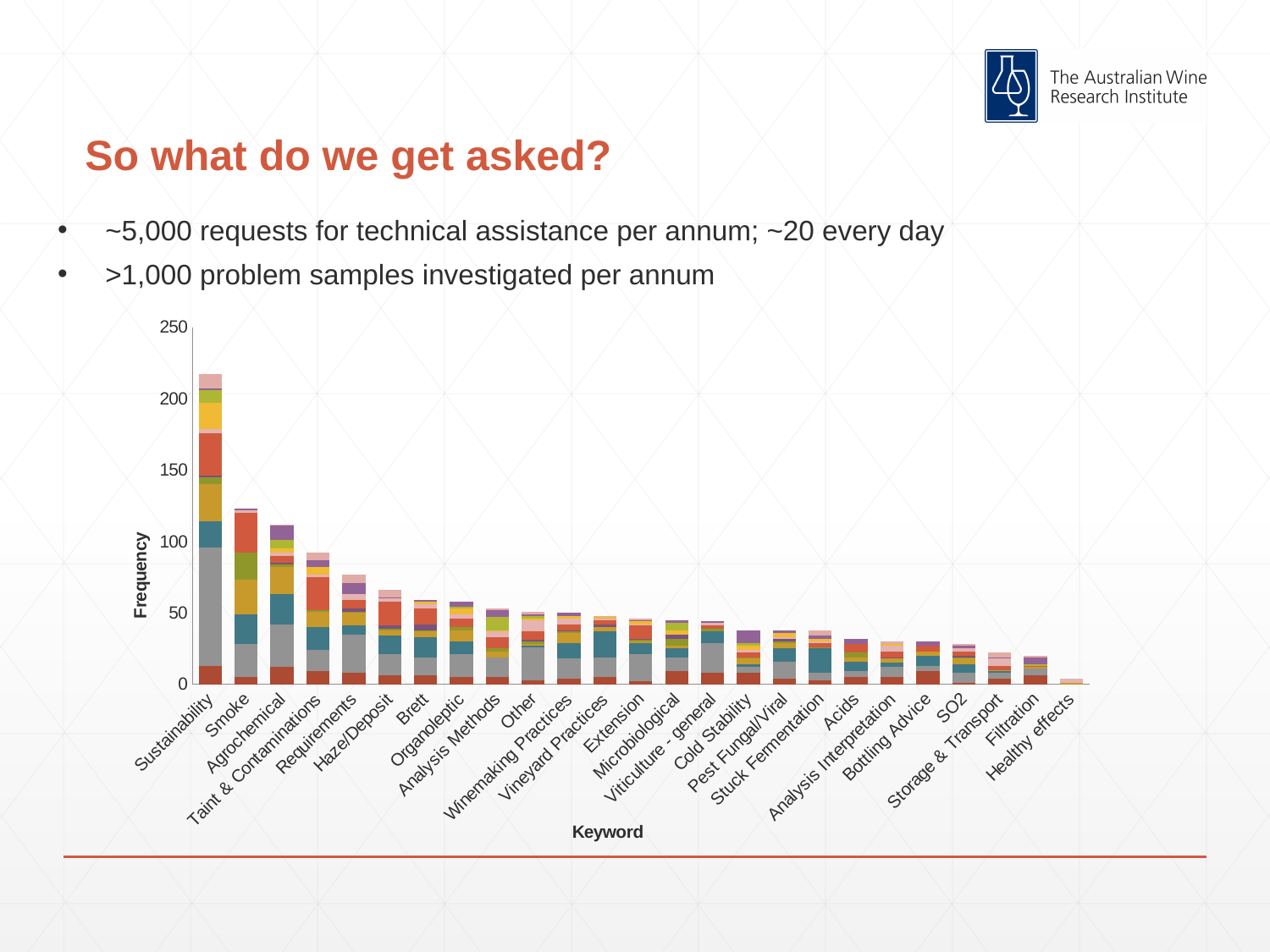
Which has a higher total frequency, Taint & Contaminations or Requirements? Taint & Contaminations Is the total frequency for Taint & Contaminations greater or less than 100? less Do the total frequencies rise or fall moving from left to right along the x axis? fall How many keyword categories are plotted along the x axis of the chart? 25 Is the total frequency for Smoke greater or less than 100? greater What kind of chart is shown on the slide? Stacked bar chart Which keyword has the highest total frequency in the chart? Sustainability Is the total frequency for Extension greater or less than 50? less What is the title of the chart's vertical axis? Frequency Which keyword has the lowest total frequency in the chart? Healthy effects Which has a higher total frequency, Sustainability or Smoke? Sustainability